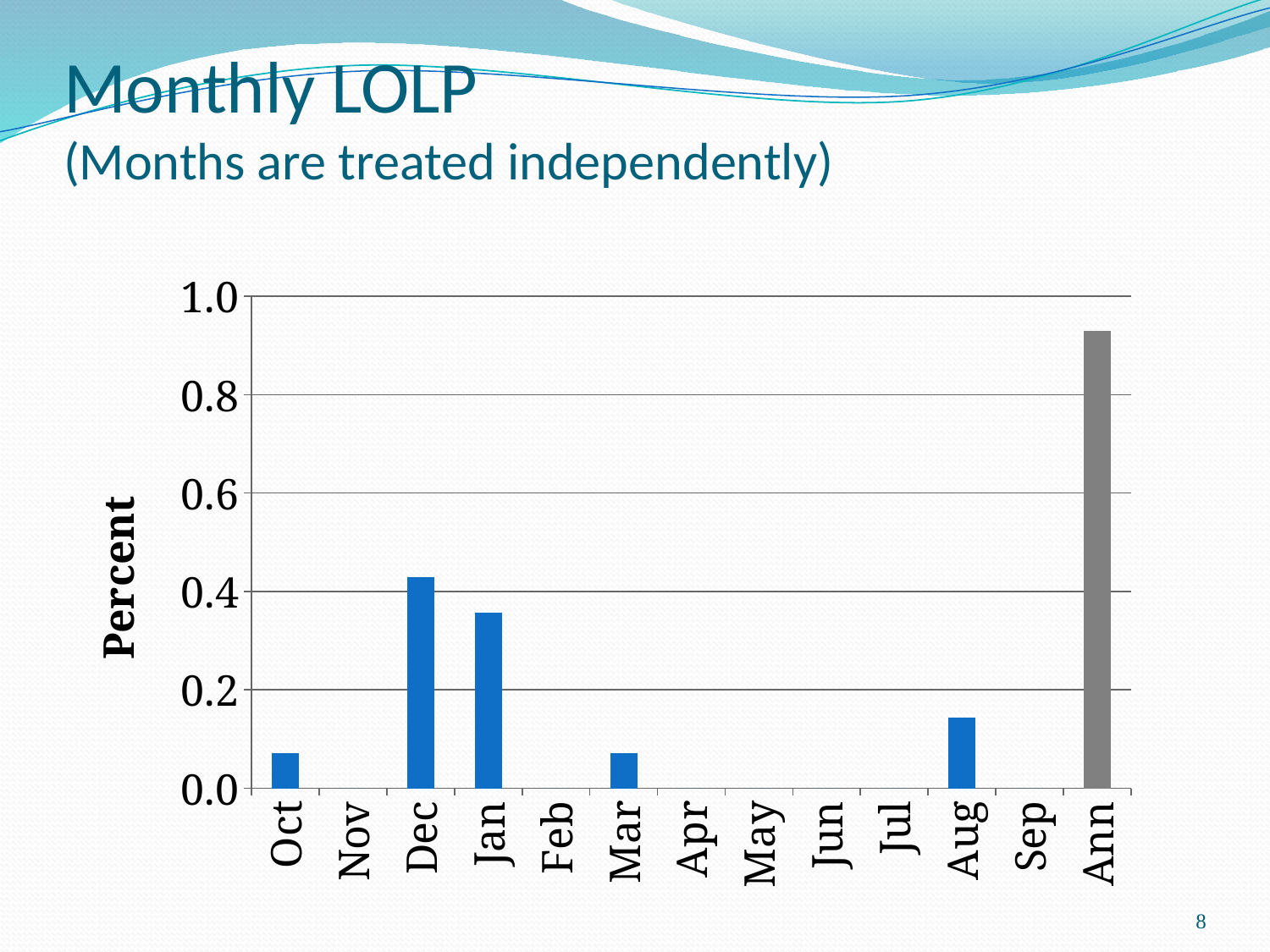
Is the value for Jan greater or less than 0.4? less How many months show no visible bar in the chart? 7 Which is larger, the value for Dec or the value for Jan? Dec Which category has the highest bar in the chart? Ann What is the label on the y axis of the chart? Percent Is the value for Dec greater or less than 0.4? greater What kind of chart is shown on the slide? bar chart Is the value for Ann greater or less than 0.8? greater How many categories are shown on the x axis of the chart? 13 Which is larger, the value for Aug or the value for Oct? Aug Among the individual months (excluding Ann), which month has the highest bar? Dec